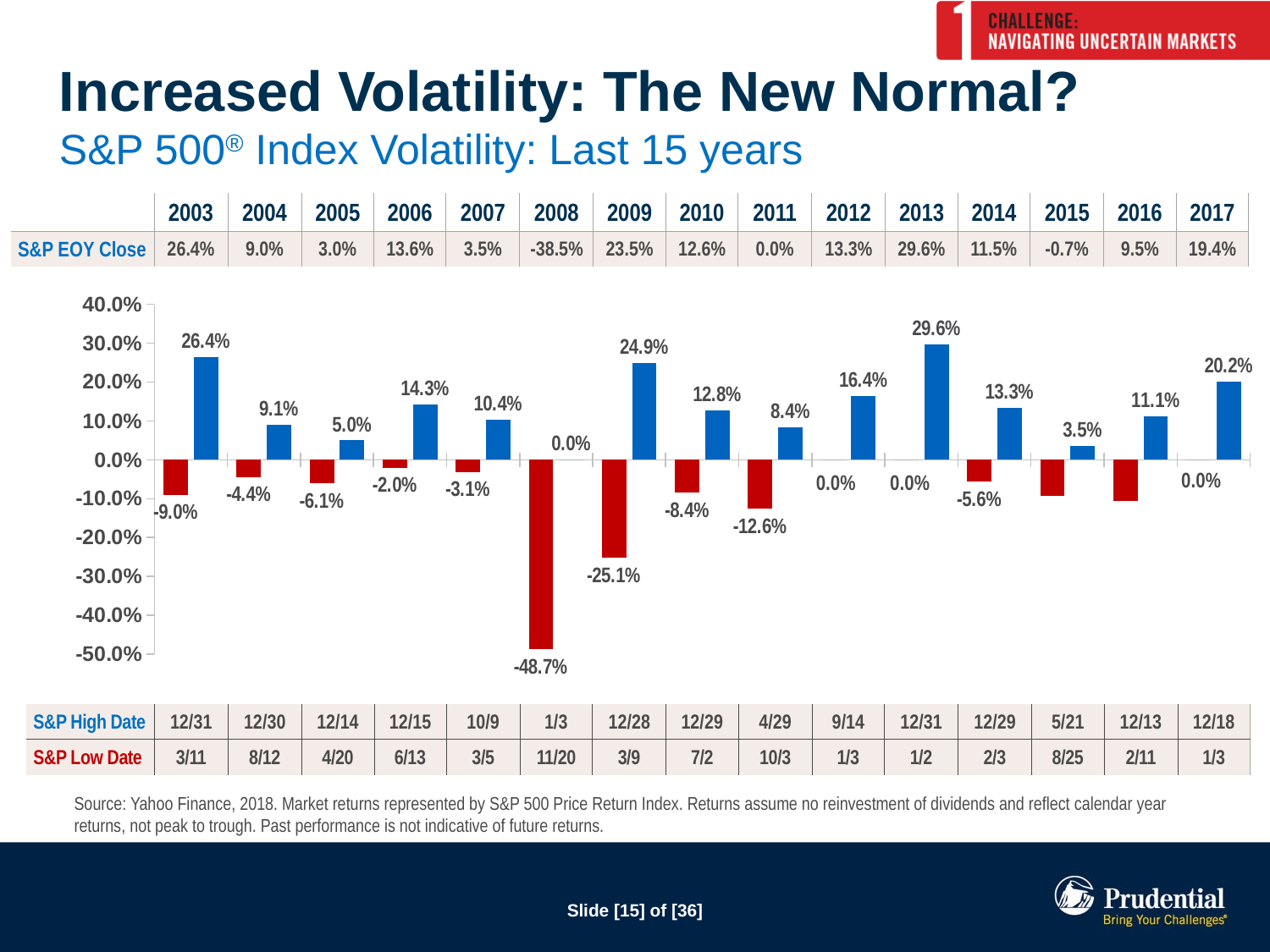
Is the red bar for 2008 greater or less than -40.0%? less What kind of chart is shown on the slide? bar chart How many years are plotted in the bar chart? 15 What is the value of the red bar for 2011 in the chart? -12.6% What is the value of the red bar for 2009 in the chart? -25.1% What is the value of the blue bar for 2017 in the chart? 20.2% What is the difference between the blue bar for 2003 (26.4%) and the blue bar for 2004 (9.1%)? 17.3 percentage points What colour are the negative bars in the chart? red Which is larger, the blue bar for 2009 or the blue bar for 2013? 2013 What is the lowest value shown in the bar chart? -48.7% What is the value of the blue bar for 2003 in the chart? 26.4% What is the highest value shown in the bar chart? 29.6%